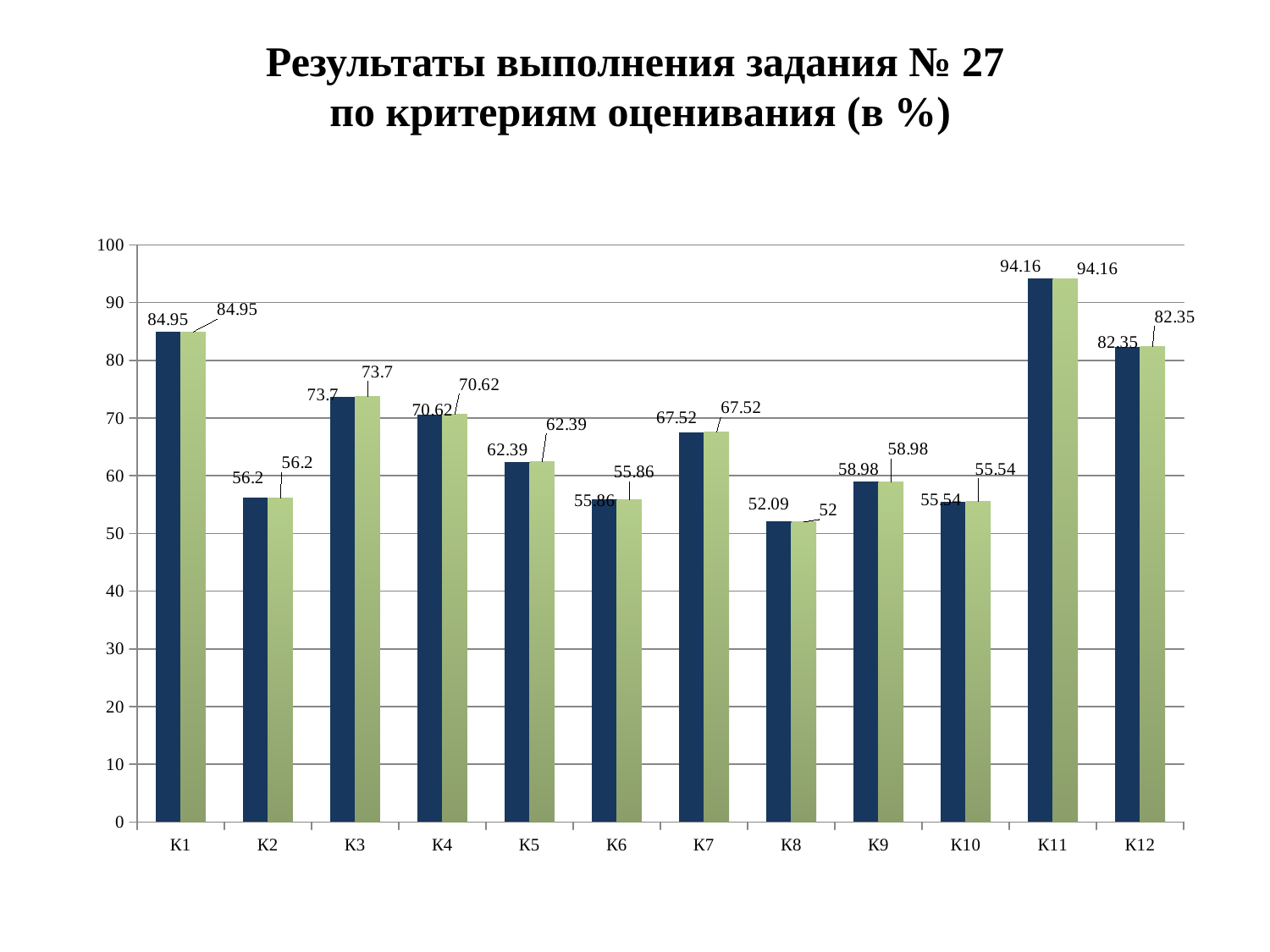
What is the value shown for K5? 62.39 Which category has the lowest value? K8 How many categories are shown on the x axis? 12 Is the value for K9 greater or less than 60? less What is the difference between the values for K11 and K12? 11.81 What is the difference between the values for K1 and K2? 28.75 What value is labelled on the dark blue bar for K8? 52.09 What kind of chart is shown on the slide? bar chart Which is larger, the value for K3 or the value for K4? K3 Which category has the highest value? K11 What value is labelled on the light green bar for K8? 52 What is the value shown for K11? 94.16